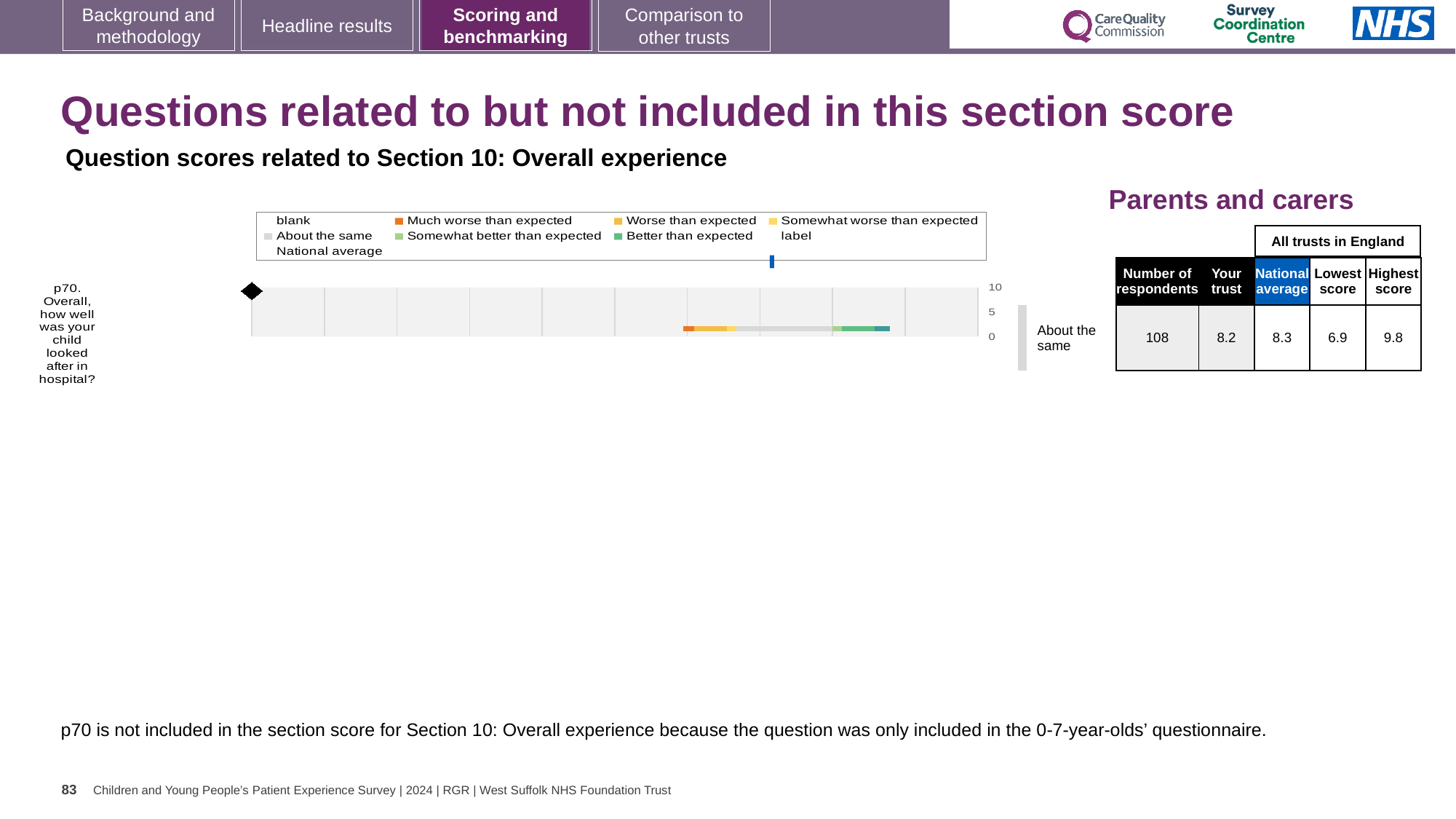
How many questions are plotted in the chart? 1 How many respondents answered question p70? 108 What is the highest score among all trusts in England for question p70? 9.8 What is the maximum value shown on the chart's score axis? 10 What kind of chart is used to show the p70 result? Bar chart What is the difference between the national average and the 'Your trust' score for question p70? 0.1 What is the 'Your trust' score for question p70 (Overall, how well was your child looked after in hospital?)? 8.2 What is the difference between the highest score and the lowest score for question p70? 2.9 Which is larger for question p70: the 'Your trust' score or the national average? National average What is the lowest score among all trusts in England for question p70? 6.9 What is the national average score for question p70? 8.3 What benchmark category label is shown next to the bar for question p70? About the same